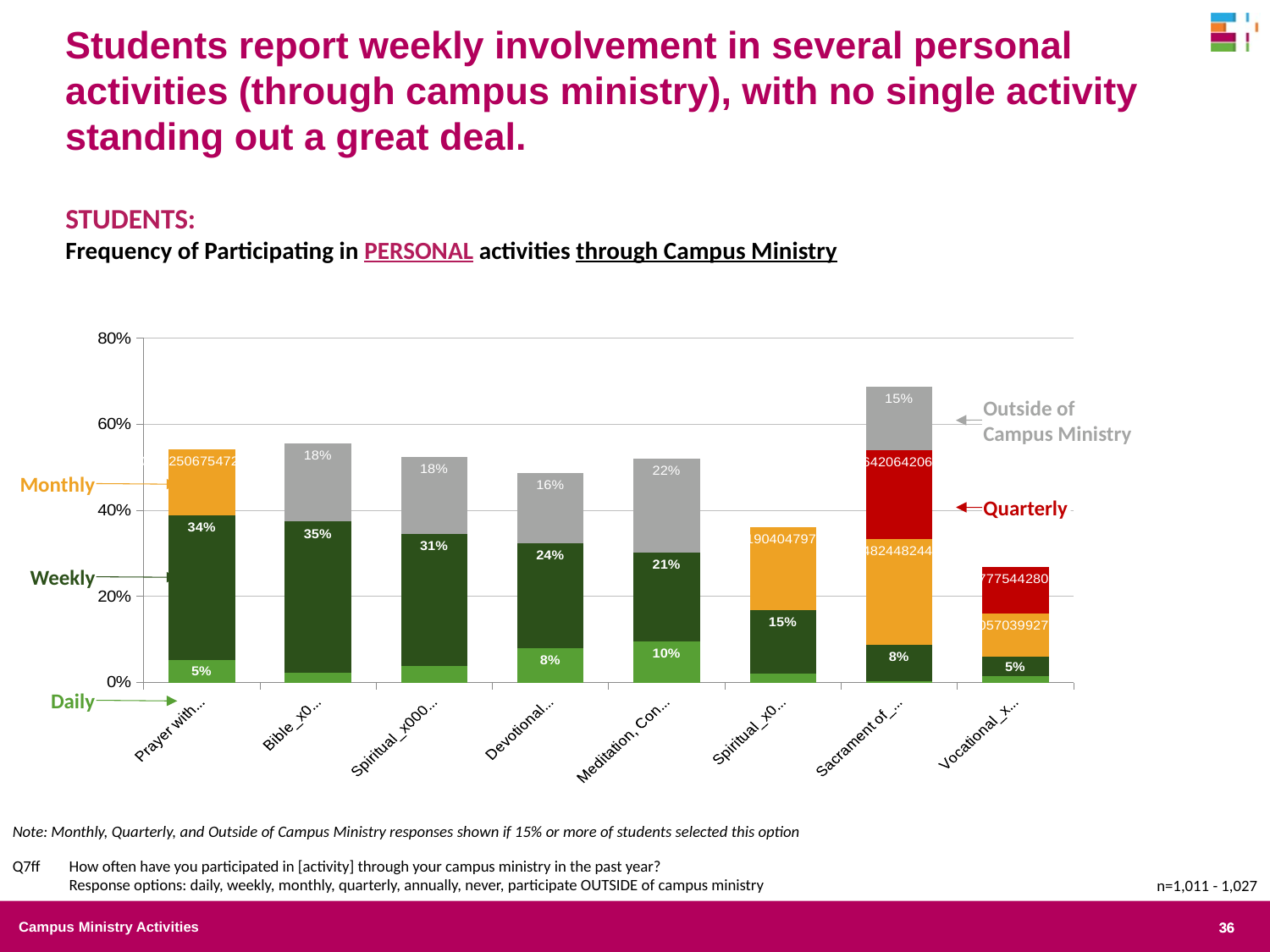
What colour are the Weekly segments of the bars? Dark green What kind of chart is shown on the slide? Stacked bar chart Which has the larger Daily value, the Devotional category or the Meditation category? Meditation Which category has the highest Weekly value? Bible (35%) How many activity categories are plotted along the x axis? 8 What is the Daily value for the Meditation category? 10% What is the difference between the Weekly value for the first category (Prayer with...) and the Weekly value for the Devotional category? 10 percentage points What is the Outside of Campus Ministry value for the Meditation category? 22% How many frequency series are labelled on the chart (Daily, Weekly, Monthly, Quarterly, Outside of Campus Ministry)? 5 Is the total height of the Sacrament of... bar greater or less than 60%? greater Among the categories with a printed Weekly label, which has the lowest Weekly value? Vocational... (5%) What is the Weekly value for the second category (Bible...)? 35%